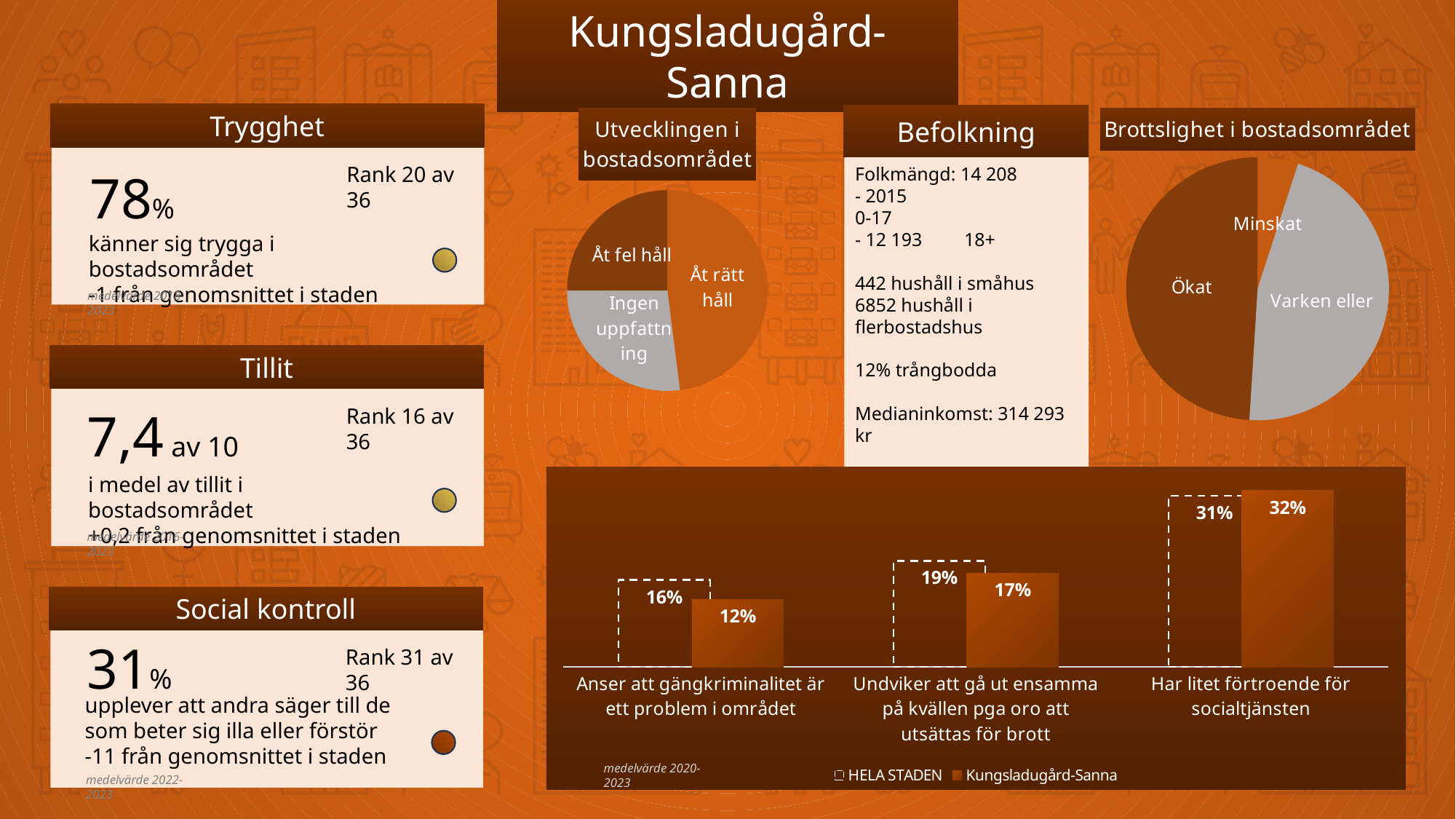
In the bar chart at the bottom of the slide, which is larger for 'Har litet förtroende för socialtjänsten': HELA STADEN or Kungsladugård-Sanna? Kungsladugård-Sanna In the bar chart at the bottom of the slide, what is the value for HELA STADEN for 'Har litet förtroende för socialtjänsten'? 31% What kind of chart is the chart titled 'Brottslighet i bostadsområdet'? Pie chart How many slices does the pie chart titled 'Utvecklingen i bostadsområdet' have? 3 In the bar chart at the bottom of the slide, what is the value for HELA STADEN for 'Undviker att gå ut ensamma på kvällen pga oro att utsättas för brott'? 19% In the bar chart at the bottom of the slide, which category has the lowest value for HELA STADEN? Anser att gängkriminalitet är ett problem i området In the bar chart at the bottom of the slide, what is the difference between HELA STADEN and Kungsladugård-Sanna for 'Anser att gängkriminalitet är ett problem i området'? 4% In the bar chart at the bottom of the slide, which category has the highest value for Kungsladugård-Sanna? Har litet förtroende för socialtjänsten What are the three slice labels in the pie chart titled 'Brottslighet i bostadsområdet'? Ökat, Minskat, Varken eller How many categories are shown in the bar chart at the bottom of the slide? 3 In the bar chart at the bottom of the slide, what is the value for Kungsladugård-Sanna for 'Anser att gängkriminalitet är ett problem i området'? 12% How many series does the legend of the bar chart at the bottom of the slide list? 2